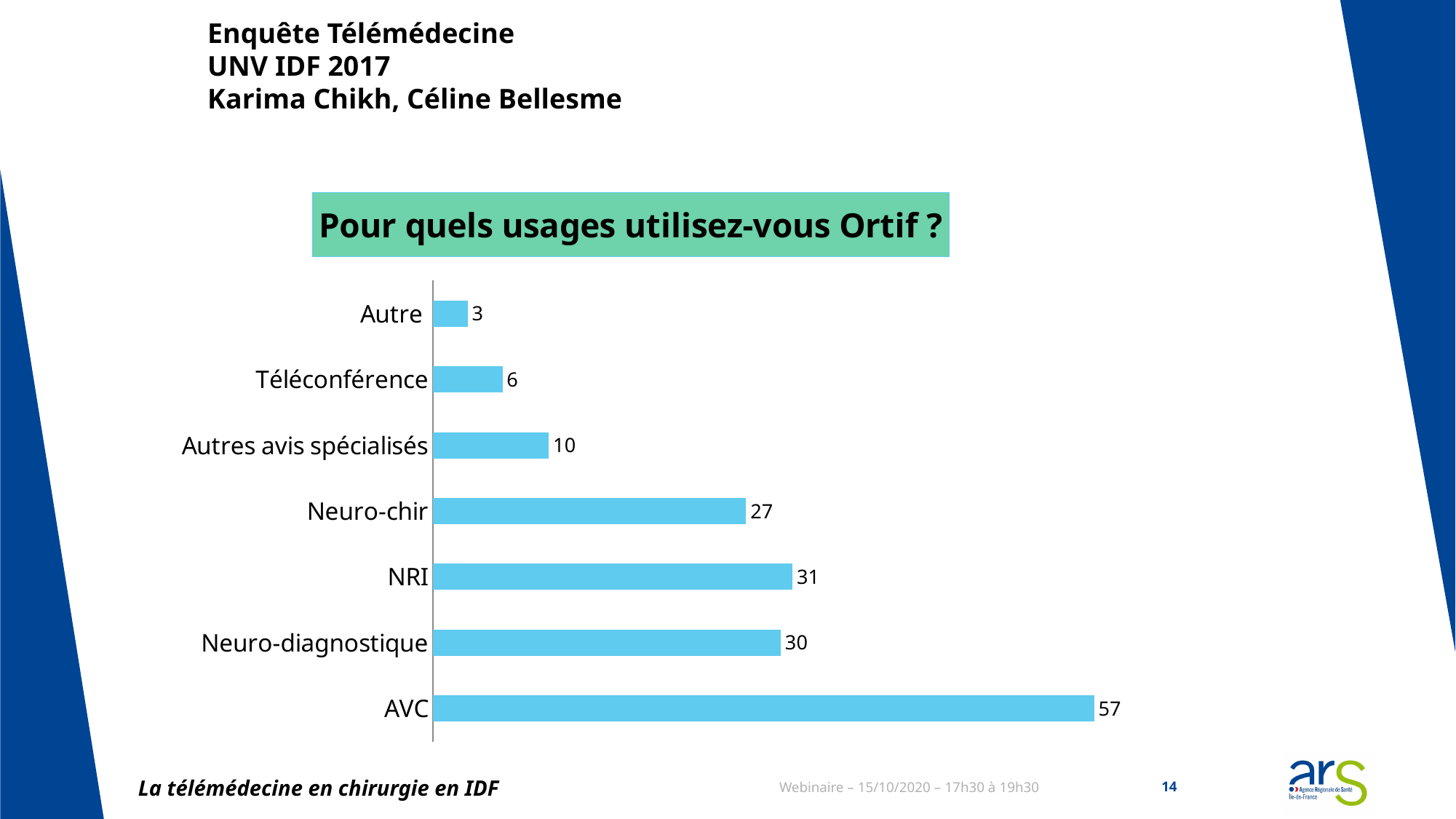
What is the difference between the values for Autres avis spécialisés and Autre? 7 What is the value for Téléconférence? 6 Which category has the highest value? AVC What is the value for Neuro-chir? 27 What is the title of the chart? Pour quels usages utilisez-vous Ortif ? What is the difference between the values for AVC and NRI? 26 What colour are the bars in the chart? light blue What is the value for AVC? 57 Which category has the lowest value? Autre Which is larger, the value for Neuro-diagnostique or the value for Neuro-chir? Neuro-diagnostique What kind of chart is shown on the slide? bar chart How many categories are shown in the chart? 7